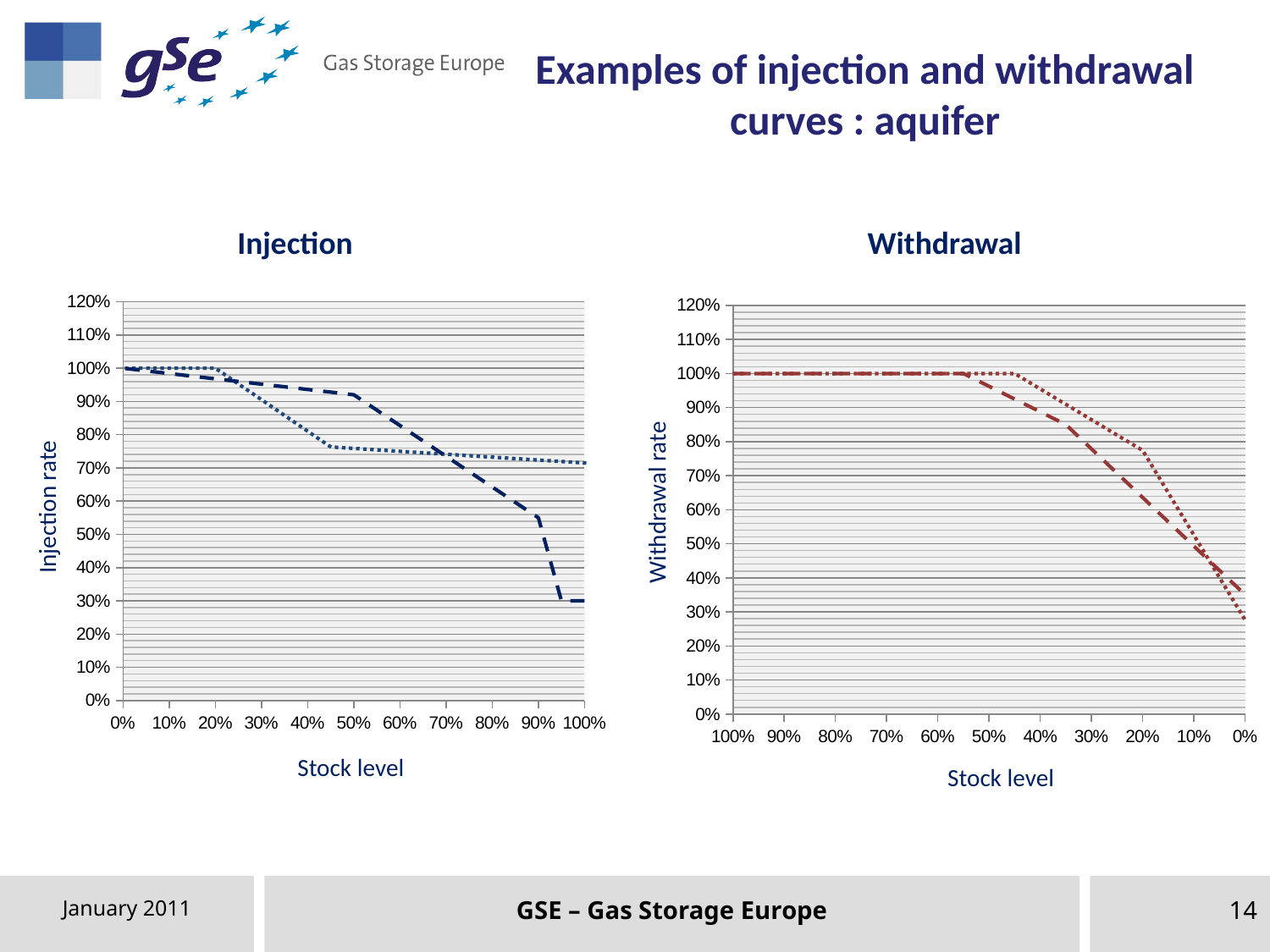
In the Injection chart, is the value of the dashed line at a stock level of 90% greater or less than 70%? less What is the label of the vertical axis on the Withdrawal chart? Withdrawal rate What is the label of the horizontal axis on the Injection chart? Stock level What kind of chart is the Withdrawal chart? line chart In the Injection chart, is the value of the dotted line at a stock level of 50% greater or less than 70%? greater In the Withdrawal chart, do the withdrawal rates rise or fall as the stock level moves from 100% to 0% along the x axis? fall What kind of chart is the Injection chart? line chart In the Withdrawal chart, is the value of the dotted line at a stock level of 0% greater or less than 40%? less In the Withdrawal chart, what is the withdrawal rate at a stock level of 100%? 100% In the Injection chart, what is the injection rate at a stock level of 0%? 100% In the Injection chart, do the injection rates rise or fall as the stock level increases from 0% to 100%? fall